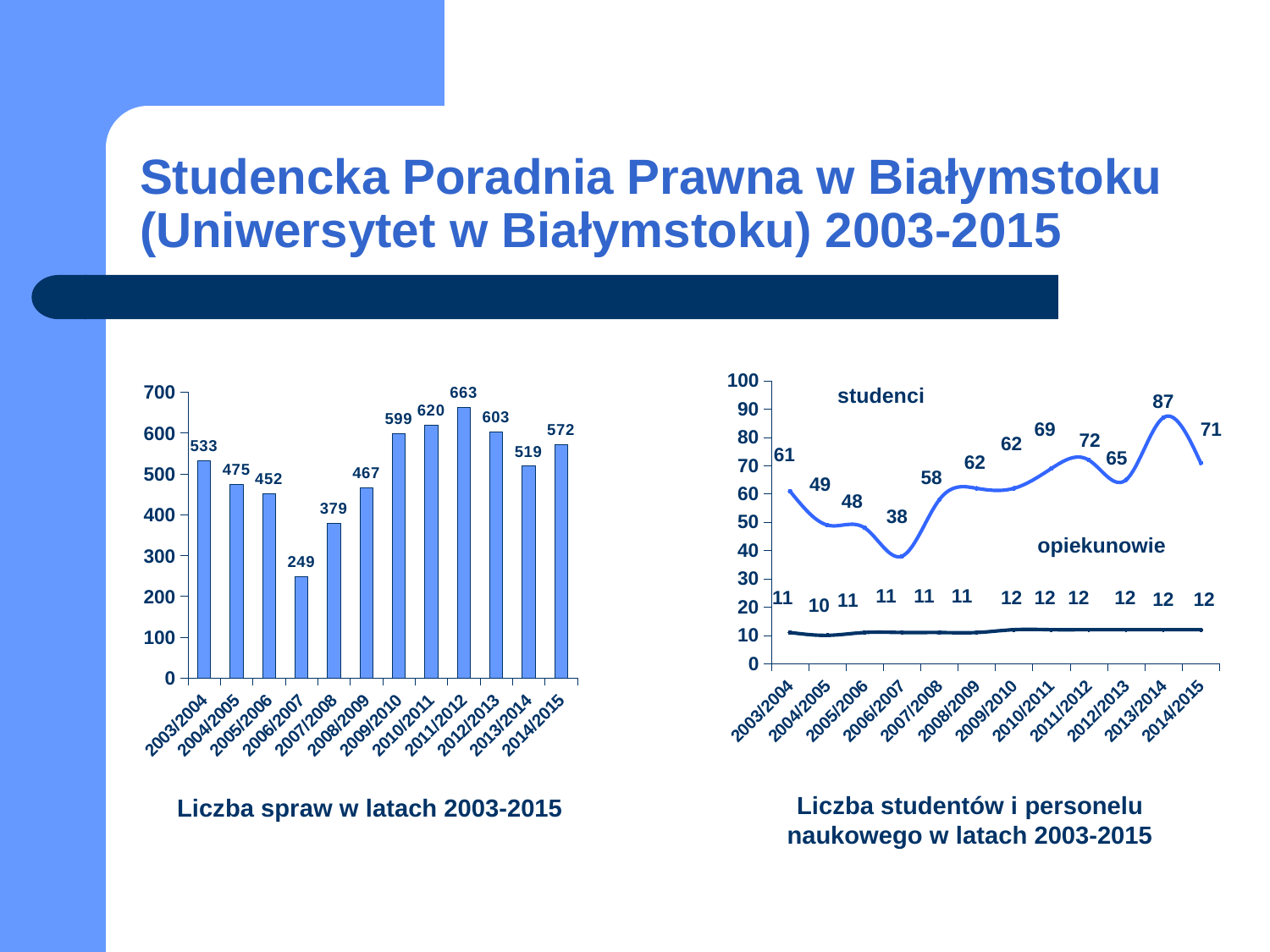
In the right chart (Liczba studentów i personelu naukowego), what is the value for studenci in 2013/2014? 87 In the left chart (Liczba spraw w latach 2003-2015), what is the value for 2006/2007? 249 In the left chart (Liczba spraw w latach 2003-2015), which year has the lowest value? 2006/2007 What kind of chart is the right chart (Liczba studentów i personelu naukowego)? line chart What kind of chart is the left chart (Liczba spraw w latach 2003-2015)? bar chart In the right chart (Liczba studentów i personelu naukowego), how many series are plotted? 2 In the right chart (Liczba studentów i personelu naukowego), in which year is the studenci value lowest? 2006/2007 In the left chart (Liczba spraw w latach 2003-2015), what is the difference between the values for 2011/2012 and 2006/2007? 414 In the left chart (Liczba spraw w latach 2003-2015), which year has the highest value? 2011/2012 In the right chart (Liczba studentów i personelu naukowego), what is the value for opiekunowie in 2004/2005? 10 In the right chart (Liczba studentów i personelu naukowego), what is the difference between studenci and opiekunowie in 2014/2015? 59 In the left chart (Liczba spraw w latach 2003-2015), how many years are shown on the x axis? 12